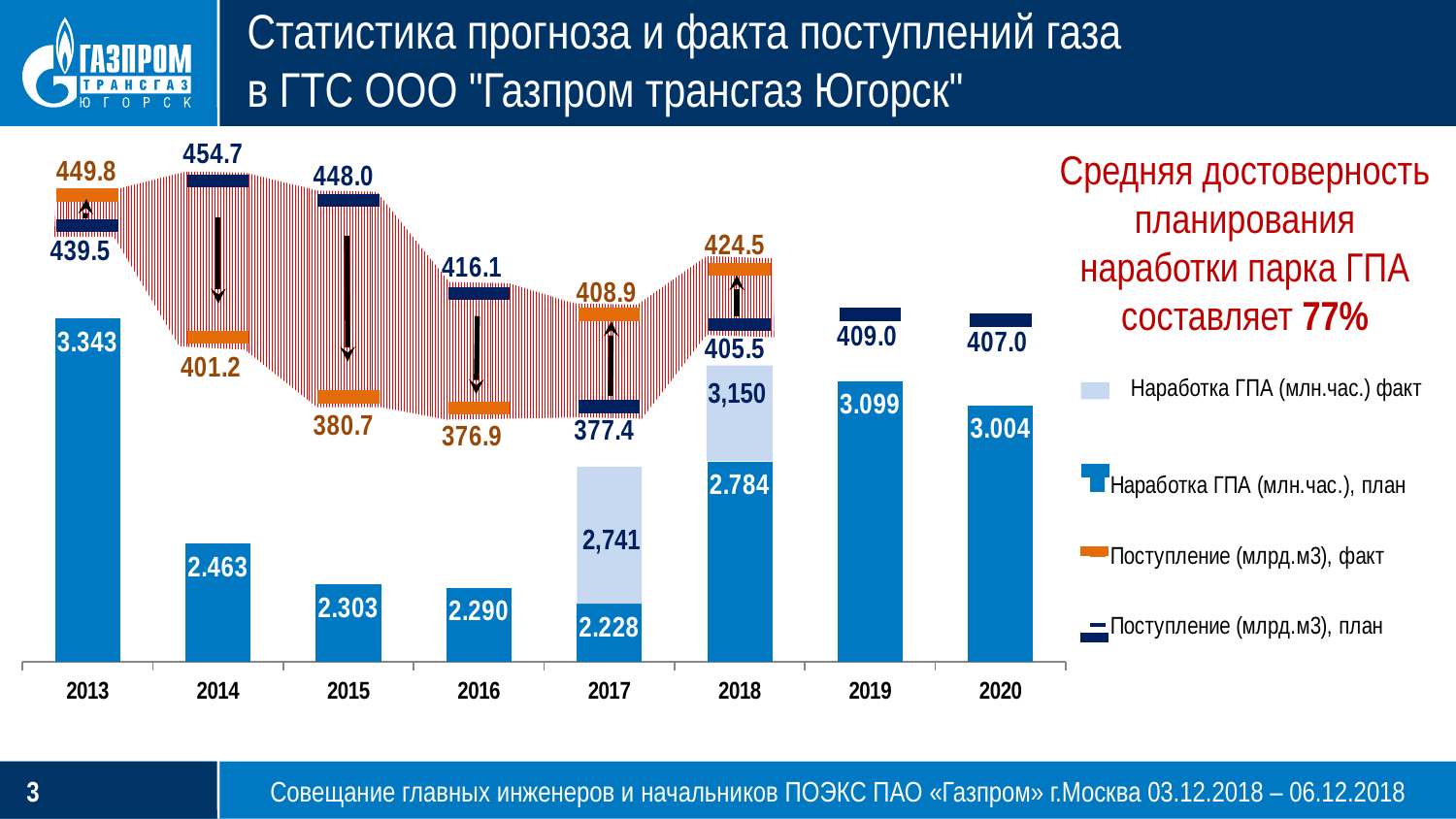
For 2014, which is larger: the planned gas receipt or the actual gas receipt? Planned (454.7) According to the text on the slide, what is the average planning accuracy of GPA fleet operating time? 77% What is the actual gas receipt (Поступление, факт) value for 2016? 376.9 Which year has the highest planned GPA operating time (Наработка ГПА, план)? 2013 What is the difference between the actual (408.9) and planned (377.4) gas receipt values for 2017? 31.5 How many years are shown on the x axis of the chart? 8 What is the actual GPA operating time (Наработка ГПА, факт) for 2018? 3,150 Which year has the highest actual gas receipt (Поступление, факт) value? 2013 What is the planned GPA operating time (Наработка ГПА, план) for 2013? 3.343 Which year has the lowest planned GPA operating time (Наработка ГПА, план)? 2017 What is the planned gas receipt (Поступление, план) value for 2014? 454.7 How many series does the chart legend list? 4